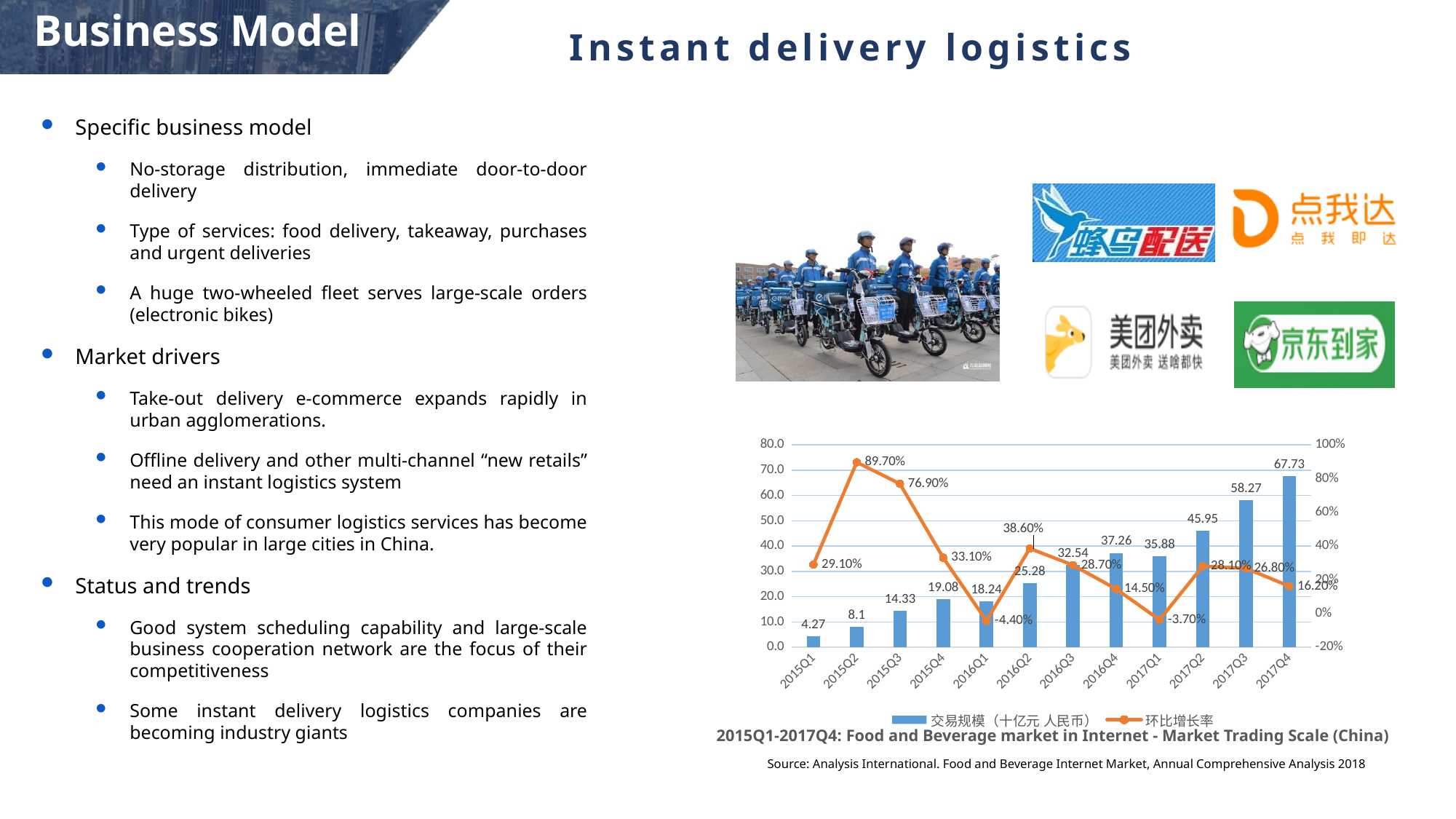
Which is larger, the trading scale bar for 2015Q4 or for 2016Q1? 2015Q4 How many quarters are shown on the x axis of the chart? 12 What kind of chart is shown on the slide? Combined bar and line chart What is the trading scale (bar) value for 2017Q4? 67.73 Which quarter has the highest trading scale bar? 2017Q4 Which quarter has the lowest growth rate on the line? 2016Q1 What is the difference between the trading scale bars for 2017Q3 and 2017Q2? 12.32 What is the trading scale (bar) value for 2016Q1? 18.24 How many series does the chart legend list? 2 What is the quarter-on-quarter growth rate shown for 2015Q2? 89.70% Do the trading scale bars generally rise or fall from 2015Q1 to 2017Q4? Rise What is the growth rate shown for 2017Q1? -3.70%